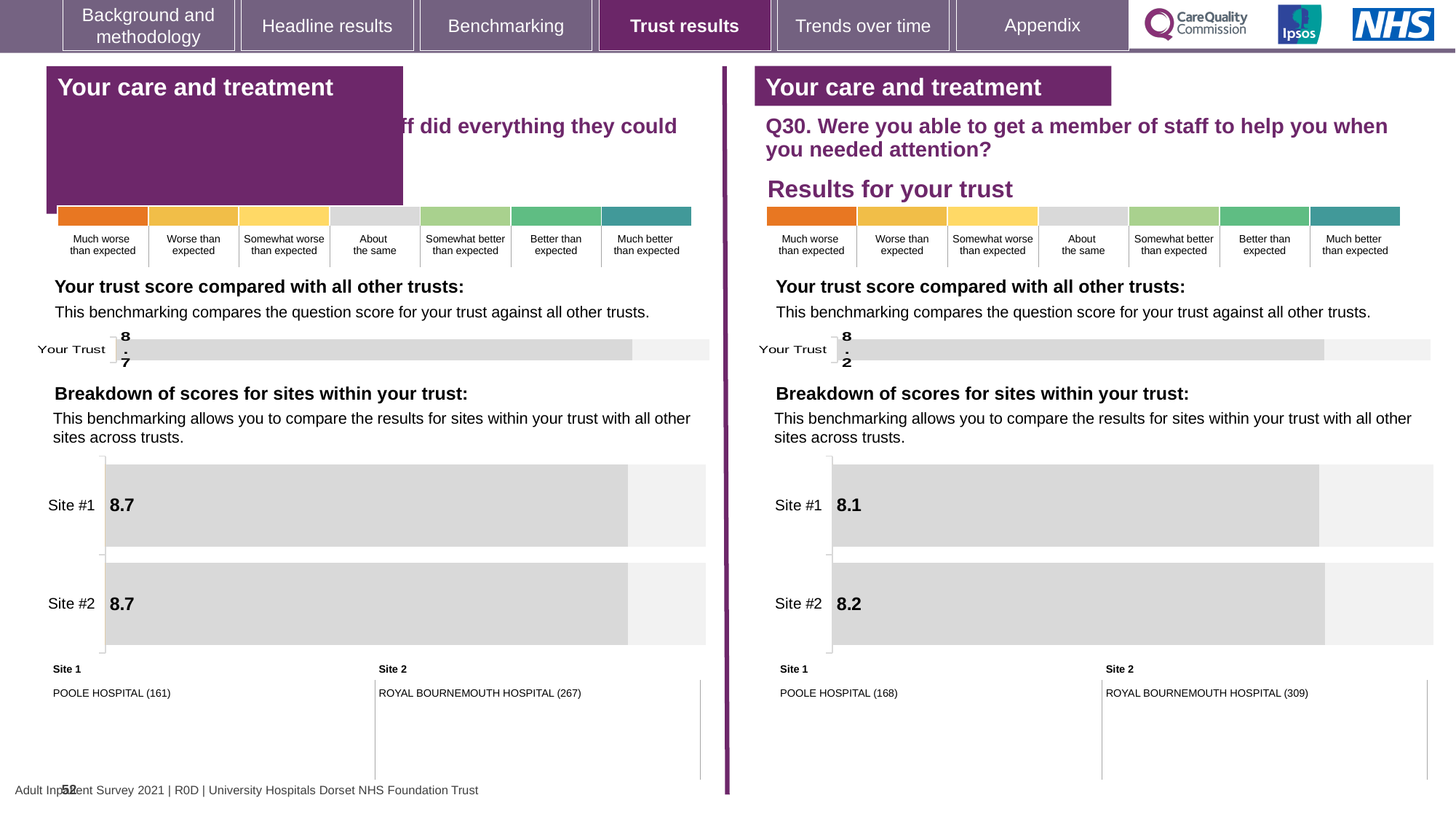
In the right-hand panel (Q30) site breakdown chart, how many sites are shown? 2 In the left-hand panel site breakdown chart, what is the score for Site #2? 8.7 In the right-hand panel (Q30), which site is labelled as Site 1 below the chart? POOLE HOSPITAL (168) In the right-hand panel (Q30), what is the score shown for Your Trust? 8.2 In the left-hand panel, which site is labelled as Site 2 below the chart? ROYAL BOURNEMOUTH HOSPITAL (267) In the left-hand panel site breakdown chart, do Site #1 and Site #2 have the same score? Yes In the right-hand panel (Q30) site breakdown chart, what is the score for Site #1? 8.1 In the right-hand panel (Q30) site breakdown chart, what is the difference between the Site #2 and Site #1 scores? 0.1 What type of chart is used for the site breakdown in the left-hand panel? Bar chart In the right-hand panel (Q30) site breakdown chart, what is the score for Site #2? 8.2 In the left-hand panel site breakdown chart, what is the score for Site #1? 8.7 In the left-hand panel, what is the score shown for Your Trust? 8.7